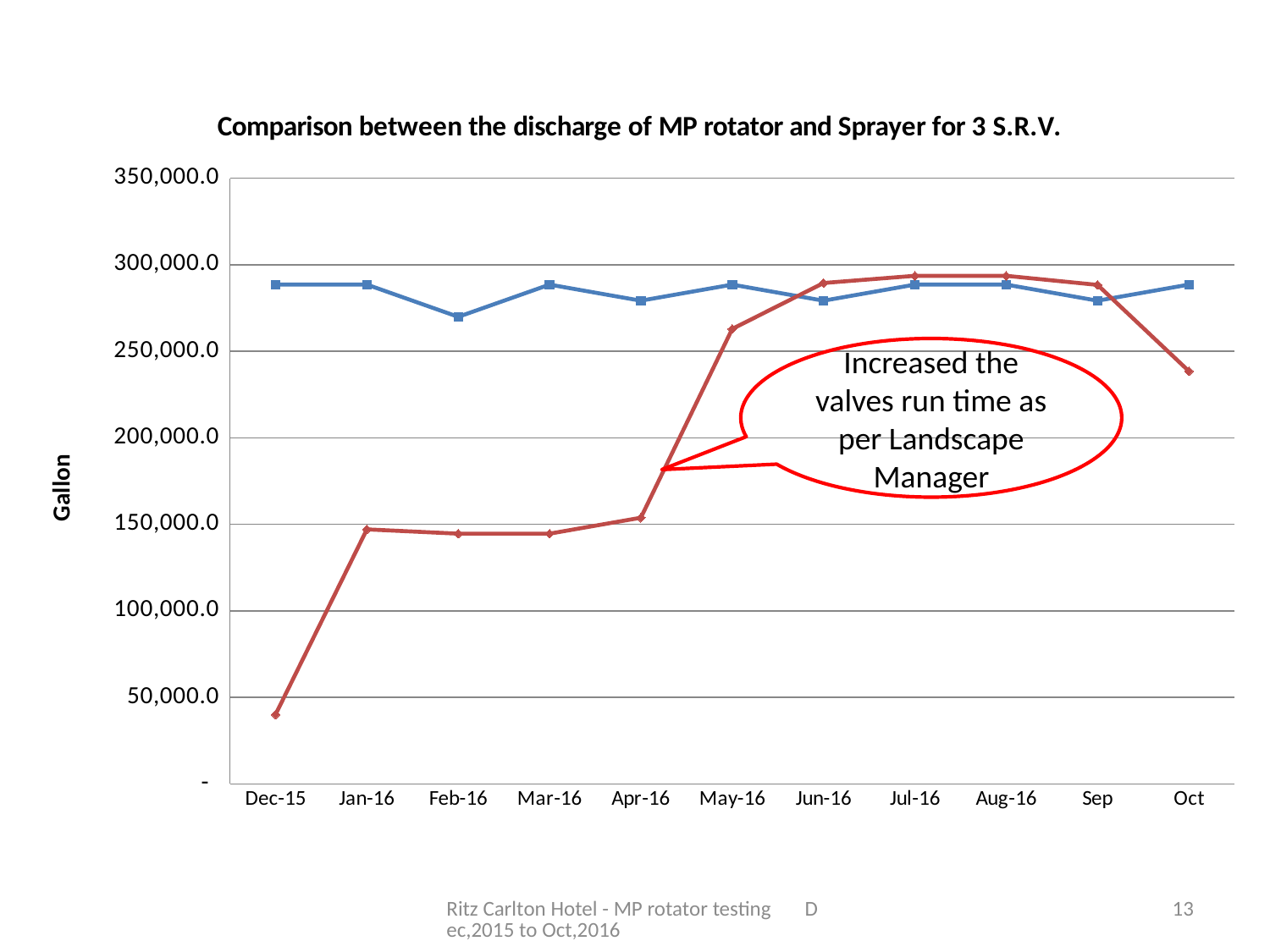
Is the value of the red line for Dec-15 greater or less than 50,000? less Is the value of the red line for Oct greater or less than 250,000? less In which month is the red line at its lowest value? Dec-15 Is the value of the blue line for Feb-16 greater or less than 250,000? greater What is the title of the chart? Comparison between the discharge of MP rotator and Sprayer for 3 S.R.V. What kind of chart is shown on the slide? line chart At Dec-15, which line has the higher value, the blue line or the red line? blue line In which month is the blue line at its lowest value? Feb-16 What is the label on the vertical axis? Gallon How many months are plotted along the x axis? 11